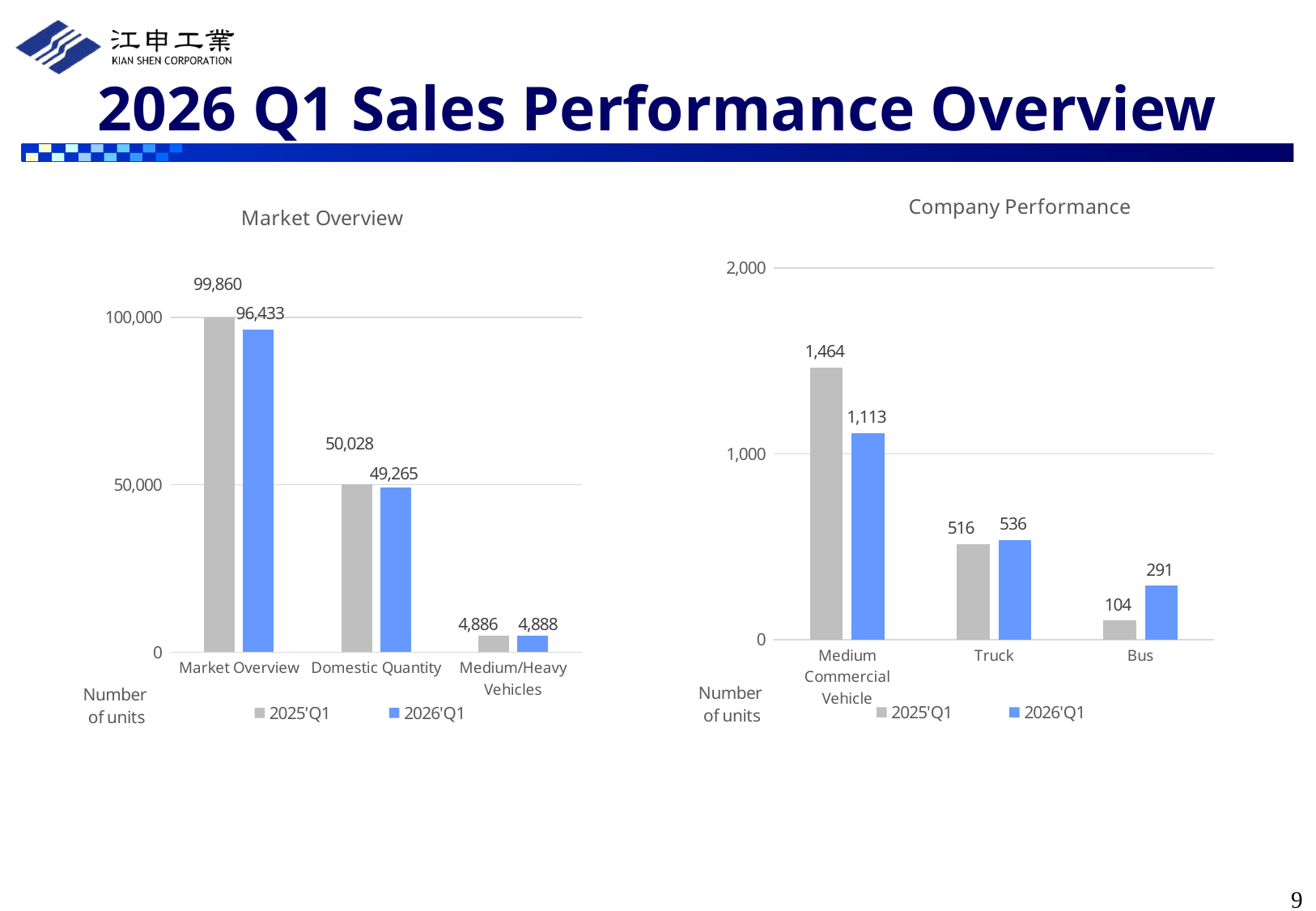
In the Company Performance chart, is the 2026'Q1 value for Truck larger or smaller than the 2025'Q1 value for Truck? larger In the Company Performance chart, what is the 2026'Q1 value for Bus? 291 In the Company Performance chart, how many categories are shown on the x axis? 3 In the Market Overview chart, what is the 2025'Q1 value for Market Overview? 99,860 In the Market Overview chart, which category has the lowest 2026'Q1 value? Medium/Heavy Vehicles In the Company Performance chart, what is the 2025'Q1 value for Medium Commercial Vehicle? 1,464 In the Market Overview chart, how many series does the legend list? 2 In the Market Overview chart, what is the 2026'Q1 value for Domestic Quantity? 49,265 In the Company Performance chart, which category has the highest 2025'Q1 value? Medium Commercial Vehicle In the Market Overview chart, what is the difference between the 2025'Q1 and 2026'Q1 values for Market Overview? 3,427 In the Company Performance chart, what is the difference between the 2026'Q1 and 2025'Q1 values for Bus? 187 What kind of chart is the Company Performance chart? bar chart